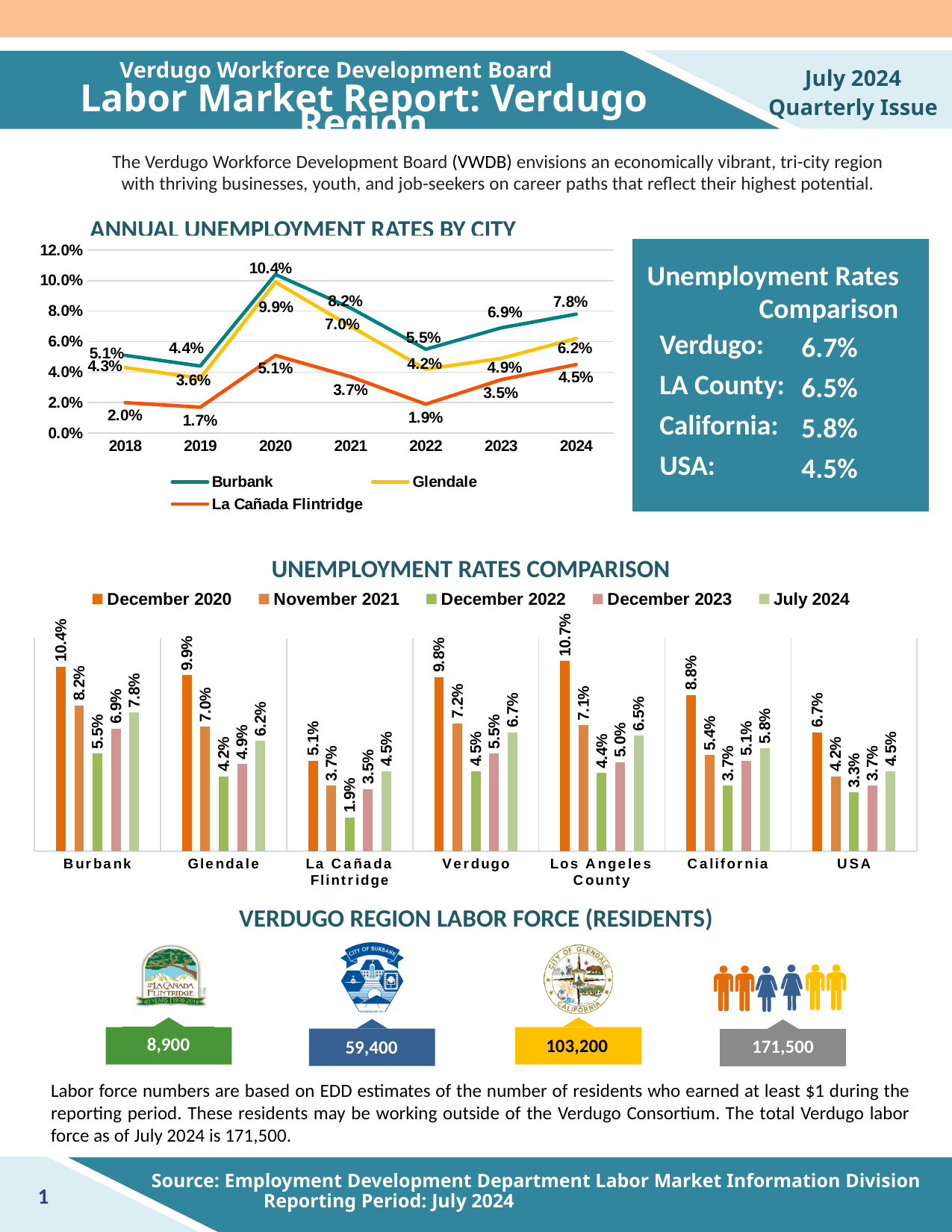
In the 'Annual Unemployment Rates by City' chart, did Burbank's rate rise or fall from 2022 to 2024? Rise In the 'Annual Unemployment Rates by City' chart, which year had the highest unemployment rate for Glendale? 2020 In the 'Unemployment Rates Comparison' chart, how many regions are shown on the x axis? 7 In the 'Unemployment Rates Comparison' chart, what was the unemployment rate for Los Angeles County in December 2020? 10.7% In the 'Annual Unemployment Rates by City' chart, what was Burbank's unemployment rate in 2020? 10.4% In the 'Unemployment Rates Comparison' chart, which is larger for July 2024: Verdugo or California? Verdugo What type of chart is 'Unemployment Rates Comparison'? Bar chart In the 'Annual Unemployment Rates by City' chart, how many series does the legend list? 3 In the 'Annual Unemployment Rates by City' chart, what was La Cañada Flintridge's unemployment rate in 2022? 1.9% What type of chart is 'Annual Unemployment Rates by City'? Line chart In the 'Annual Unemployment Rates by City' chart, what is the difference between Burbank's and Glendale's rates in 2024? 1.6%